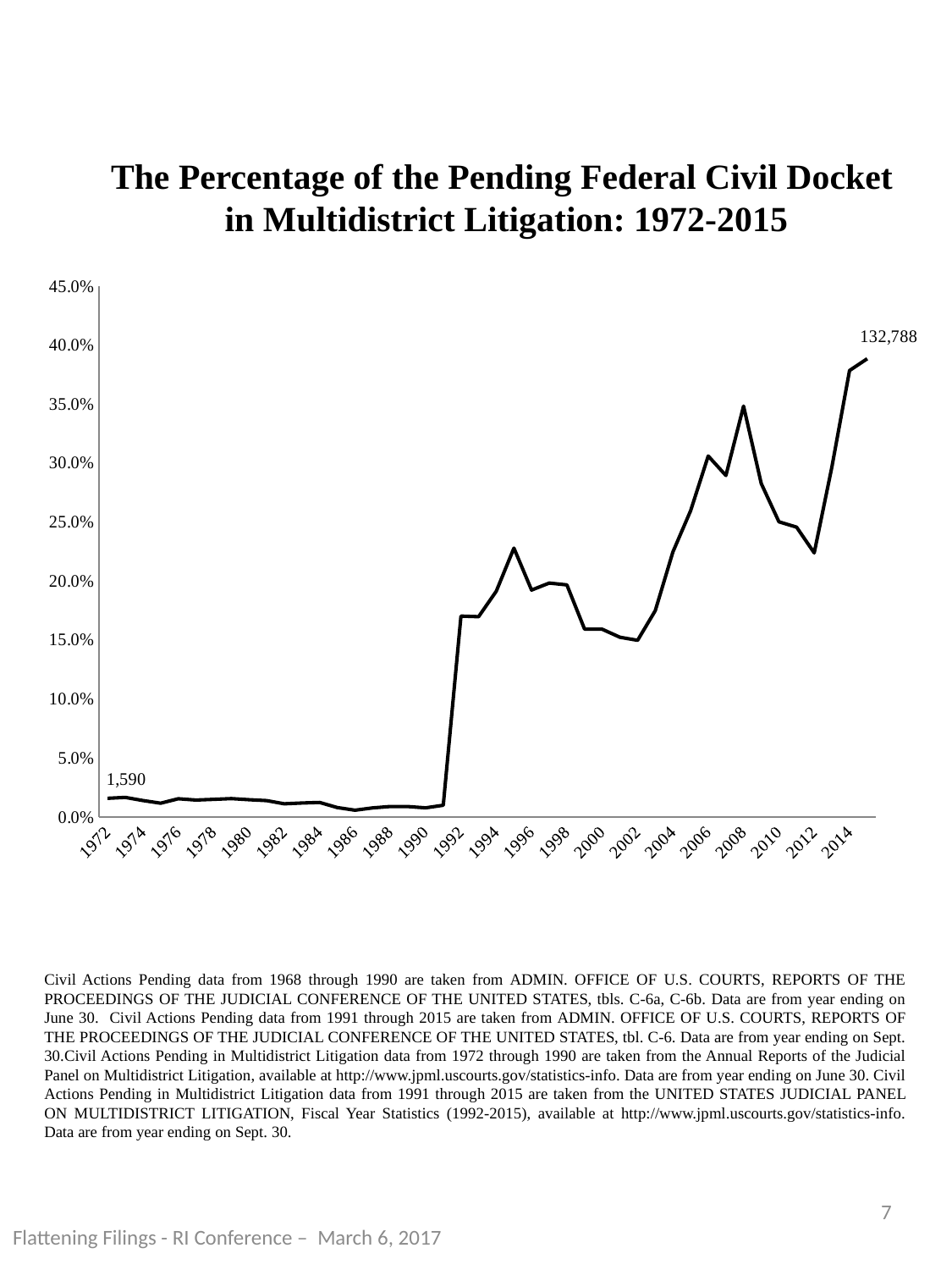
How many year labels are shown along the x axis? 22 Is the value for 1992 greater or less than 15.0%? greater What data label is printed next to the 1972 point at the start of the line? 1,590 Is the value for 1972 greater or less than 5.0%? less In which year does the line reach its highest percentage? 2015 Which year has the larger value, 2008 or 2015? 2015 Is the value for 1995 greater or less than 25.0%? less Overall, does the percentage rise or fall from 1972 to 2015? rise What is the title of the chart? The Percentage of the Pending Federal Civil Docket in Multidistrict Litigation: 1972-2015 What data label is printed next to the final point of the line, at 2015? 132,788 What kind of chart is shown on the slide? line chart